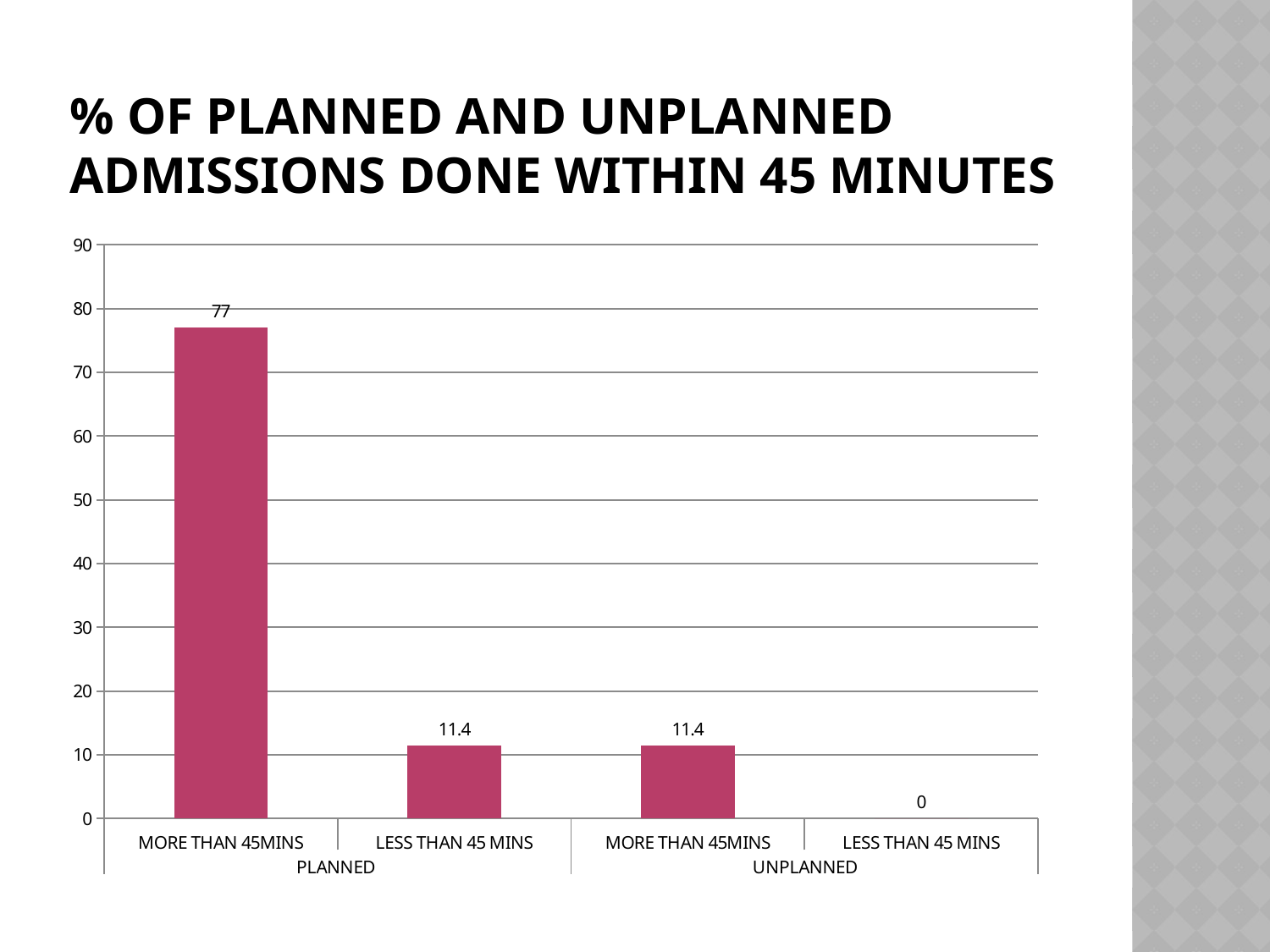
What is the title of the chart on the slide? % OF PLANNED AND UNPLANNED ADMISSIONS DONE WITHIN 45 MINUTES What is the difference between the PLANNED MORE THAN 45MINS value and the PLANNED LESS THAN 45 MINS value? 65.6 How many bars are plotted on the chart? 4 What kind of chart is shown on the slide? bar chart What is the value for LESS THAN 45 MINS under UNPLANNED? 0 Is the value for MORE THAN 45MINS under PLANNED greater or less than 70? greater Which bar has the lowest value? LESS THAN 45 MINS (UNPLANNED) Which is larger: the PLANNED MORE THAN 45MINS value or the UNPLANNED MORE THAN 45MINS value? PLANNED MORE THAN 45MINS What is the value for MORE THAN 45MINS under UNPLANNED? 11.4 Which bar has the highest value? MORE THAN 45MINS (PLANNED) What is the value for MORE THAN 45MINS under PLANNED? 77 What is the value for LESS THAN 45 MINS under PLANNED? 11.4